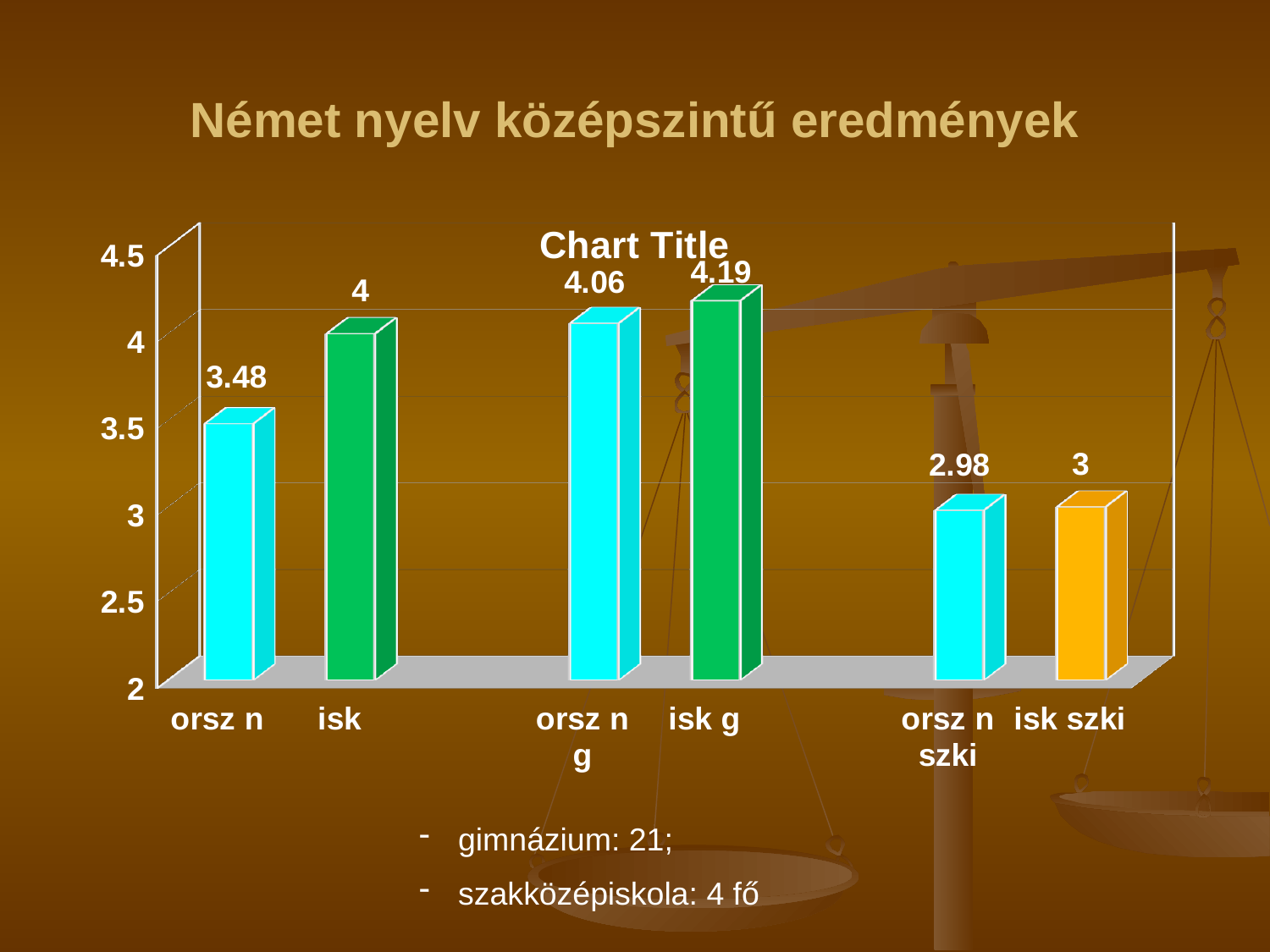
What is the value for "orsz n"? 3.48 What is the difference between the values for "isk" and "orsz n"? 0.52 What is the value for "orsz n szki"? 2.98 What is the difference between the values for "isk g" and "orsz n g"? 0.13 Which category has the highest value? isk g Which is larger, the value for "isk" or the value for "orsz n g"? orsz n g How many bars are plotted in the chart? 6 Which category has the lowest value? orsz n szki What kind of chart is shown on the slide? bar chart What is the title printed above the chart's plot area? Chart Title What is the value for "isk g"? 4.19 What is the value for "isk szki"? 3